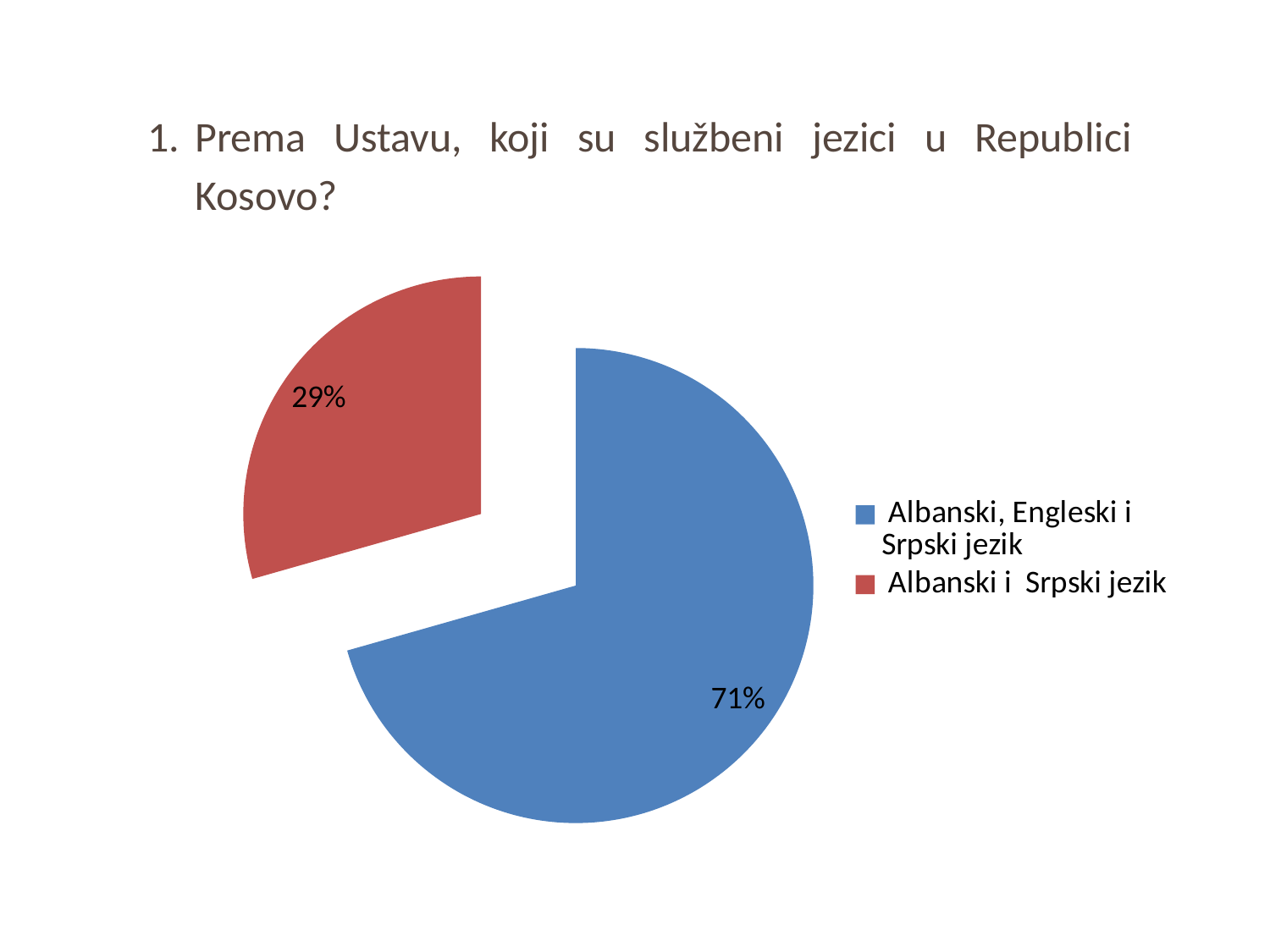
How many entries does the legend list? 2 Which category has the smallest slice of the pie? Albanski i Srpski jezik What share of the pie is labelled "Albanski i Srpski jezik"? 29% What is the difference in percentage points between the "Albanski, Engleski i Srpski jezik" slice and the "Albanski i Srpski jezik" slice? 42 What colour is the slice for "Albanski, Engleski i Srpski jezik"? blue What type of chart is shown on the slide? pie chart Which slice is larger: "Albanski, Engleski i Srpski jezik" or "Albanski i Srpski jezik"? Albanski, Engleski i Srpski jezik What share of the pie is labelled "Albanski, Engleski i Srpski jezik"? 71% What colour is the slice for "Albanski i Srpski jezik"? red How many slices does the pie chart have? 2 Which category has the largest slice of the pie? Albanski, Engleski i Srpski jezik